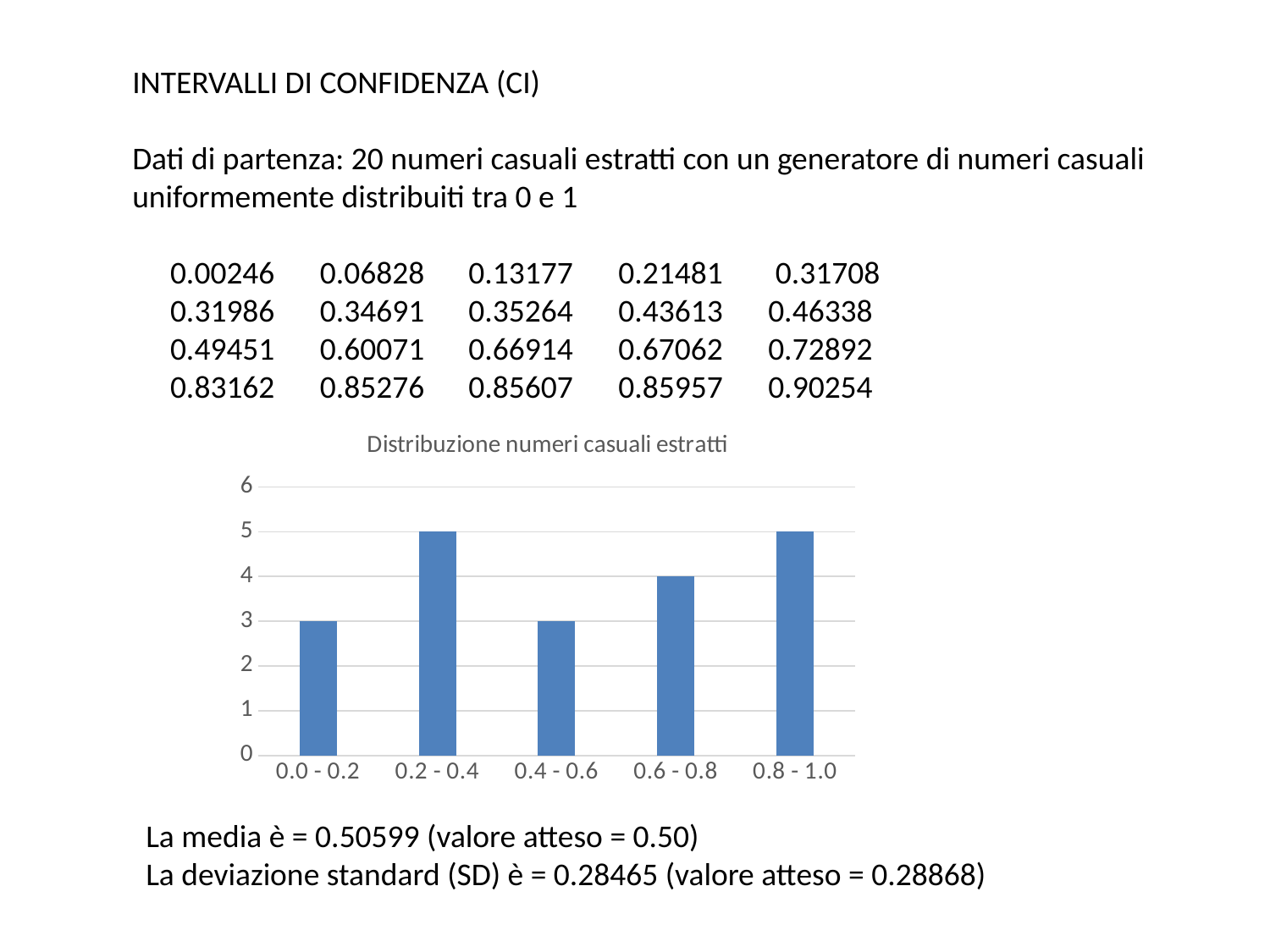
What is the value for the 0.6 - 0.8 bin in the chart? 4 What is the value for the 0.8 - 1.0 bin in the chart? 5 What is the value for the 0.4 - 0.6 bin in the chart? 3 What is the value for the 0.2 - 0.4 bin in the chart? 5 How many bins (categories) are shown on the x axis of the chart? 5 What kind of chart is shown on the slide? bar chart Is the value for the 0.6 - 0.8 bin greater or less than 3? greater Which has a larger value, the 0.6 - 0.8 bin or the 0.4 - 0.6 bin? 0.6 - 0.8 What is the value for the 0.0 - 0.2 bin in the chart? 3 What is the title of the chart? Distribuzione numeri casuali estratti What is the difference between the values for the 0.2 - 0.4 bin and the 0.6 - 0.8 bin? 1 What is the highest value reached by any bar in the chart? 5